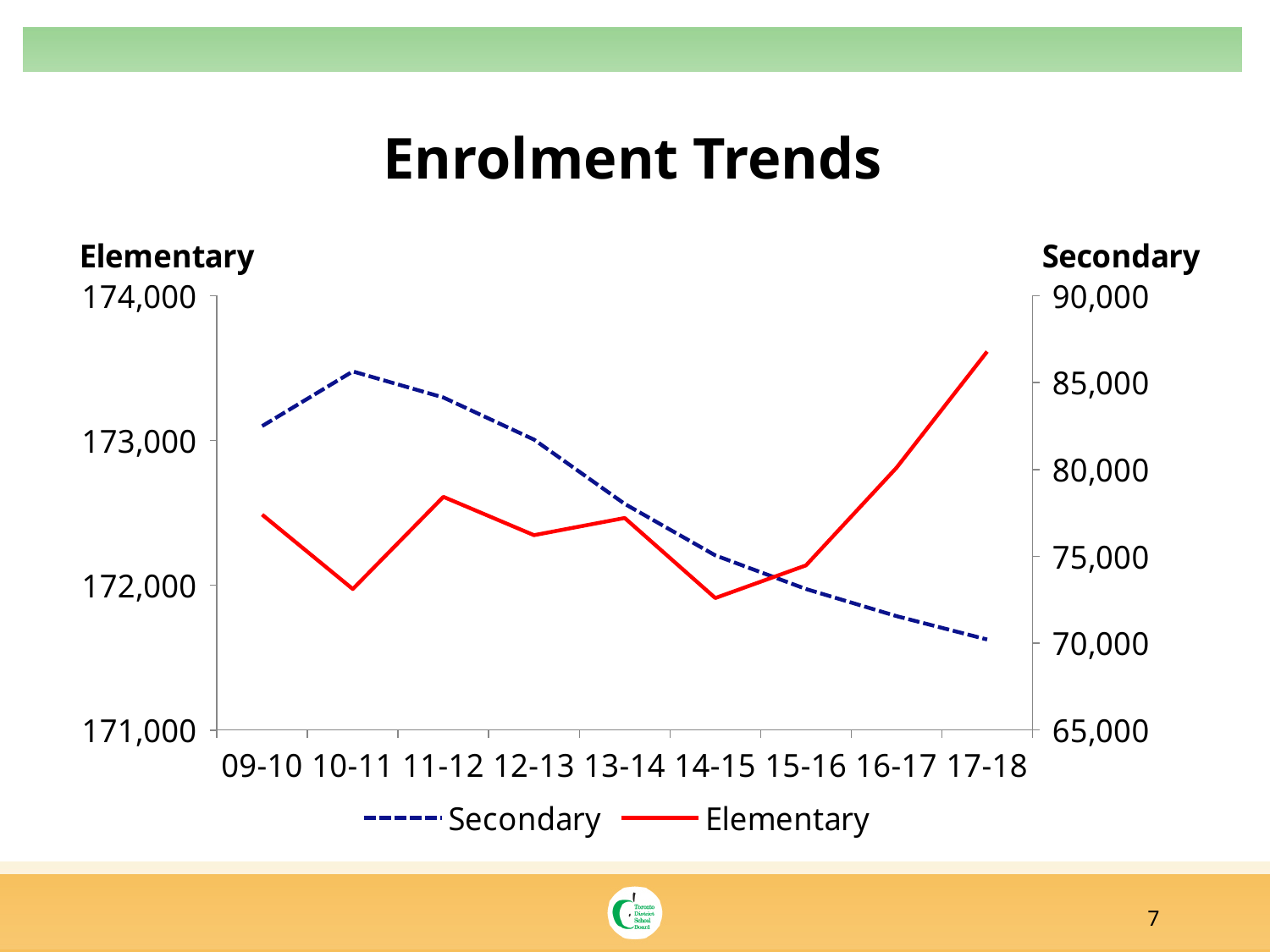
In which school year is Secondary enrolment highest? 10-11 What is the title of the chart? Enrolment Trends In which school year is Elementary enrolment highest? 17-18 How many series does the legend list? 2 What kind of chart is shown on the slide? line chart How many school years are plotted along the x axis? 9 Does the Secondary line rise or fall from 10-11 to 17-18? fall In which school year is Secondary enrolment lowest? 17-18 Is the Secondary value for 09-10 greater or less than 85,000? less Which is larger, the Elementary value for 09-10 or for 17-18? 17-18 Is the Secondary value for 15-16 greater or less than 75,000? less Is the Elementary value for 17-18 greater or less than 173,000? greater